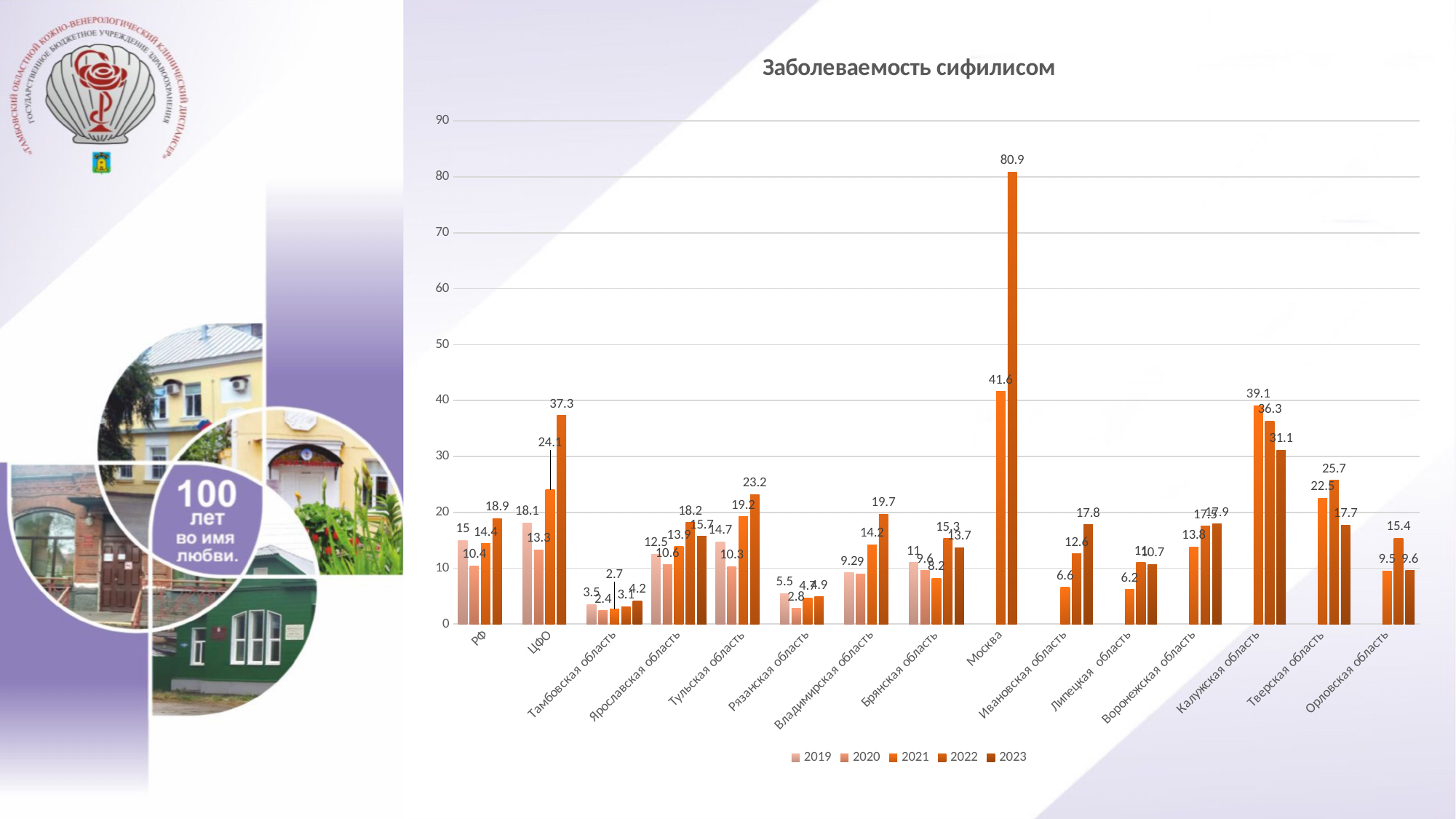
Which region has the highest value on the chart? Москва What is the highest labelled value for ЦФО? 37.3 What is the difference between the two labelled values for Москва (80.9 and 41.6)? 39.3 What kind of chart is shown on the slide? bar chart How many regions (categories) are shown on the x axis? 15 What is the title of the chart? Заболеваемость сифилисом What is the highest labelled value for Тульская область? 23.2 Is the highest value for Тамбовская область greater or less than 10? less What is the highest value shown for Москва? 80.9 Which is larger: the highest value for Калужская область or the highest value for ЦФО? Калужская область What is the difference between the highest (39.1) and lowest (31.1) labelled values for Калужская область? 8 How many series does the legend list? 5